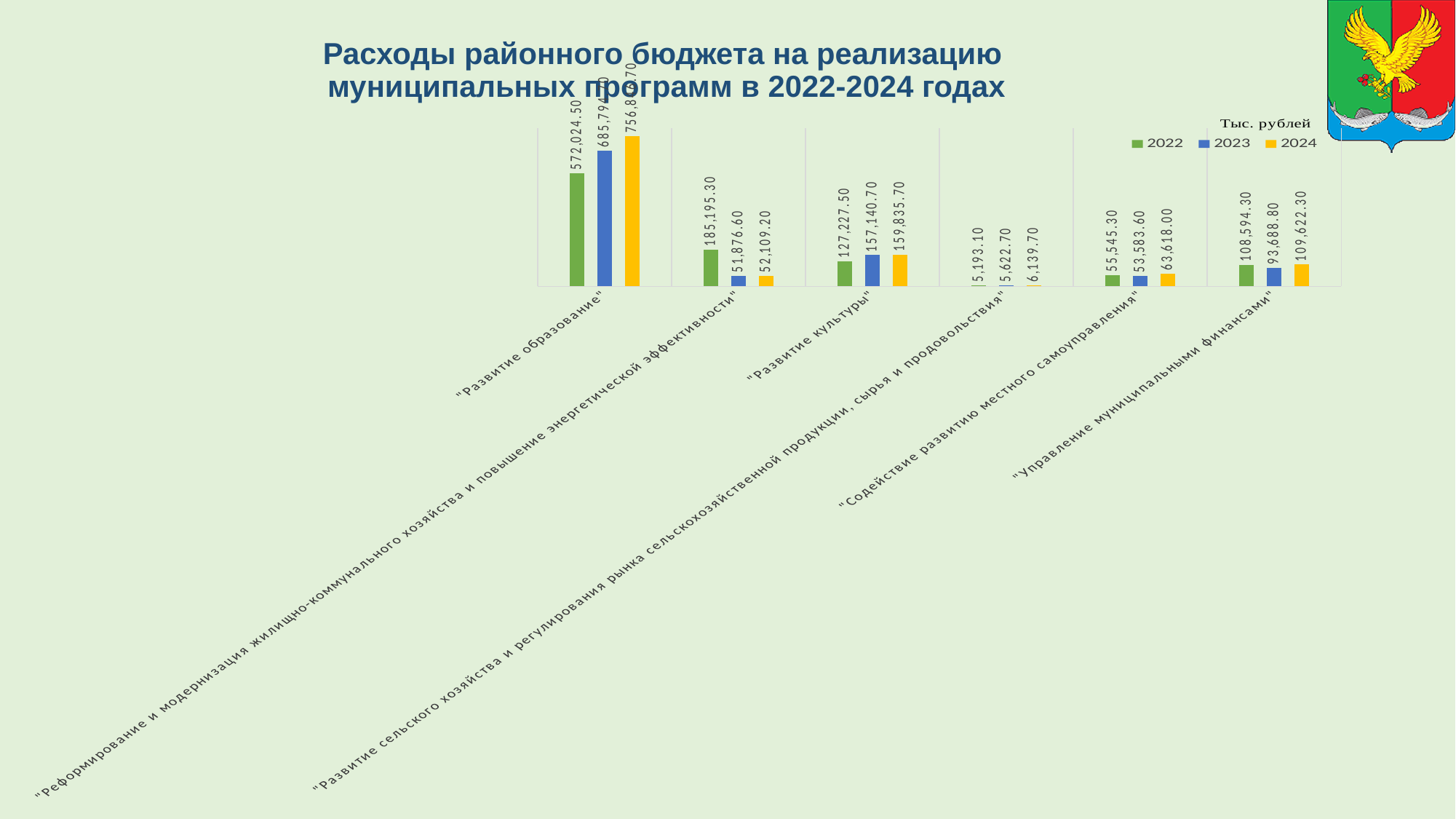
How many series does the legend list? 3 Do the values for "Развитие культуры" rise or fall from 2022 to 2024? rise Which programme has the highest value in 2022? "Развитие образование" How many programmes (categories) are shown on the chart? 6 For "Содействие развитию местного самоуправления", how much larger is the 2024 value than the 2023 value? 10,034.40 What is the 2022 value for "Реформирование и модернизация жилищно-коммунального хозяйства и повышение энергетической эффективности"? 185,195.30 What is the value for "Развитие культуры" in 2024? 159,835.70 Which programme has the lowest value in 2024? "Развитие сельского хозяйства и регулирования рынка сельскохозяйственной продукции, сырья и продовольствия" What is the value for "Развитие образование" in 2022? 572,024.50 For "Развитие культуры", which year has the larger value, 2022 or 2023? 2023 What is the value for "Управление муниципальными финансами" in 2023? 93,688.80 For "Реформирование и модернизация жилищно-коммунального хозяйства и повышение энергетической эффективности", what is the difference between the 2022 and 2023 values? 133,318.70